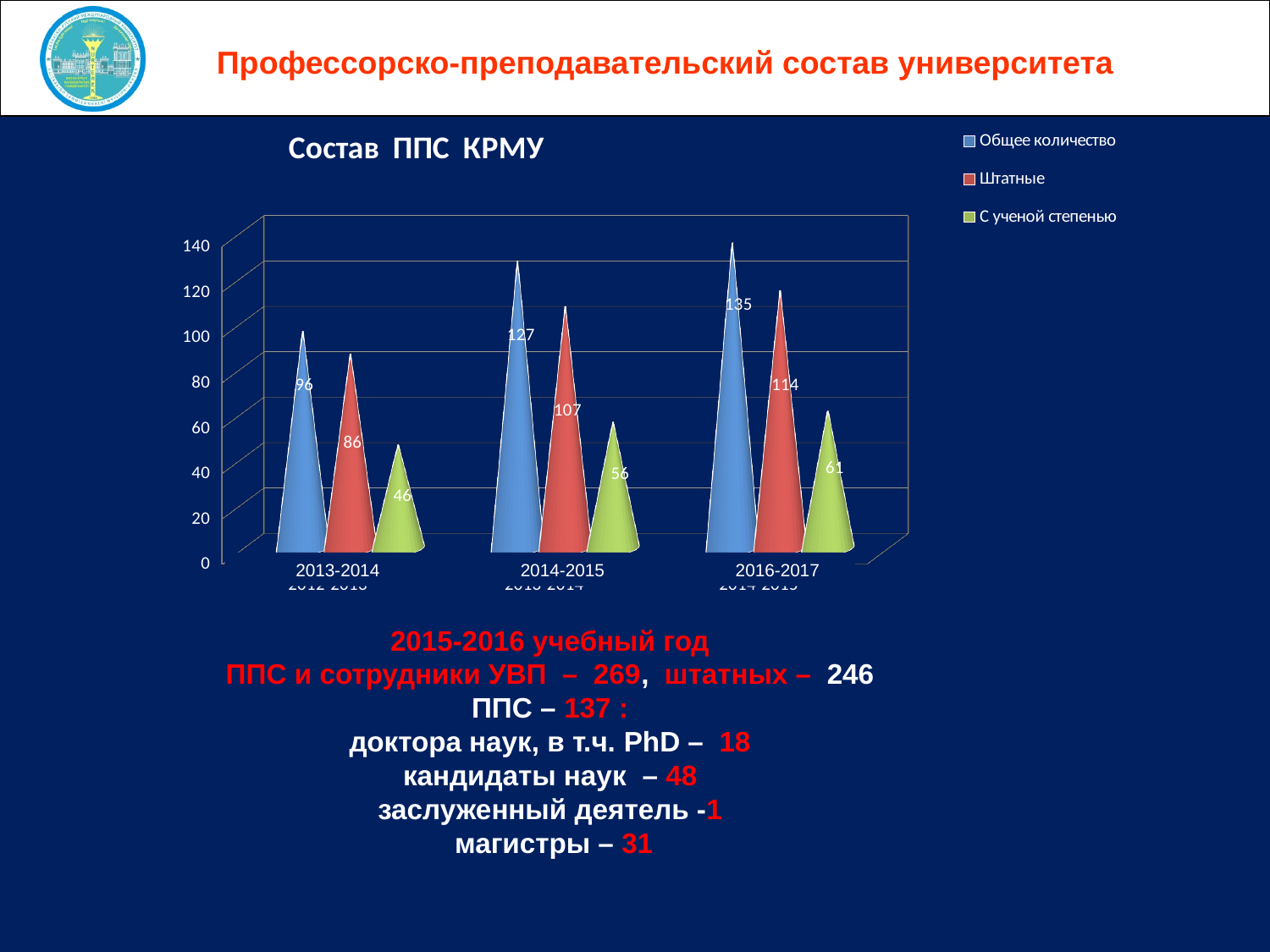
Which academic year has the highest value for Общее количество? 2016-2017 What is the difference between the Штатные values for 2014-2015 and 2013-2014? 21 What is the value of Общее количество for 2014-2015? 127 How many series does the legend list? 3 Which academic year has the lowest value for С ученой степенью? 2013-2014 What is the value of С ученой степенью for 2013-2014? 46 What is the difference between Общее количество and Штатные in 2016-2017? 21 What is the title of the chart? Состав ППС КРМУ What is the value of Штатные for 2016-2017? 114 Is the value of Общее количество for 2013-2014 greater or less than 100? less Which is larger: С ученой степенью in 2014-2015 or in 2016-2017? 2016-2017 Does the value of Общее количество rise or fall across the academic years shown? rise